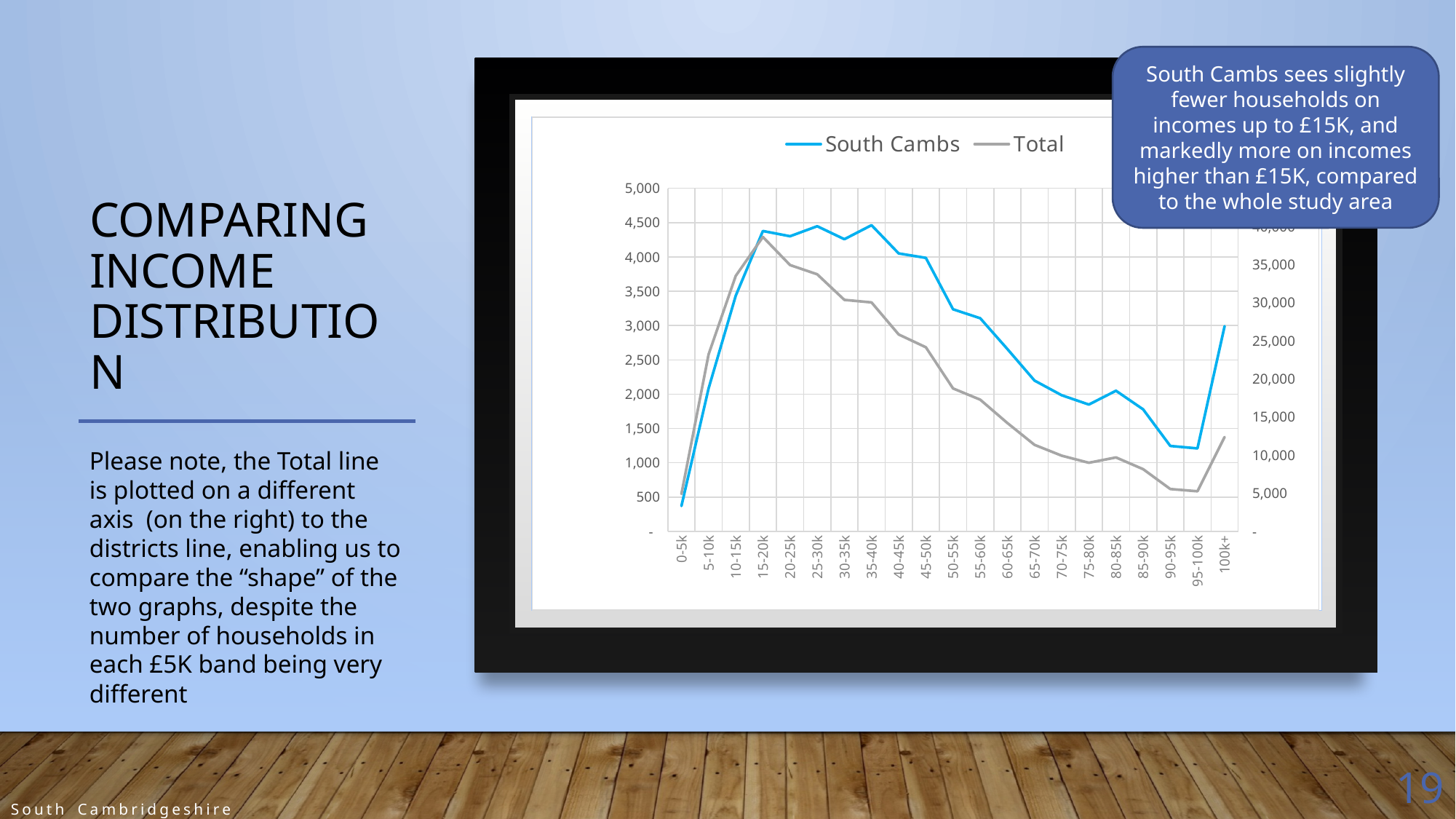
Is the South Cambs value for 35-40k greater or less than 4,000? greater Is the South Cambs value for 0-5k greater or less than 500? less Do the South Cambs values rise or fall from 35-40k to 95-100k? fall Which colour is used for the South Cambs line? blue What kind of chart is shown on the slide? line chart Is the Total value for 100k+ greater or less than 10,000 on the right axis? greater Which income band has the highest value for Total? 15-20k How many series does the chart legend list? 2 How many income bands are plotted along the x axis? 21 Which income band has the lowest value for South Cambs? 0-5k